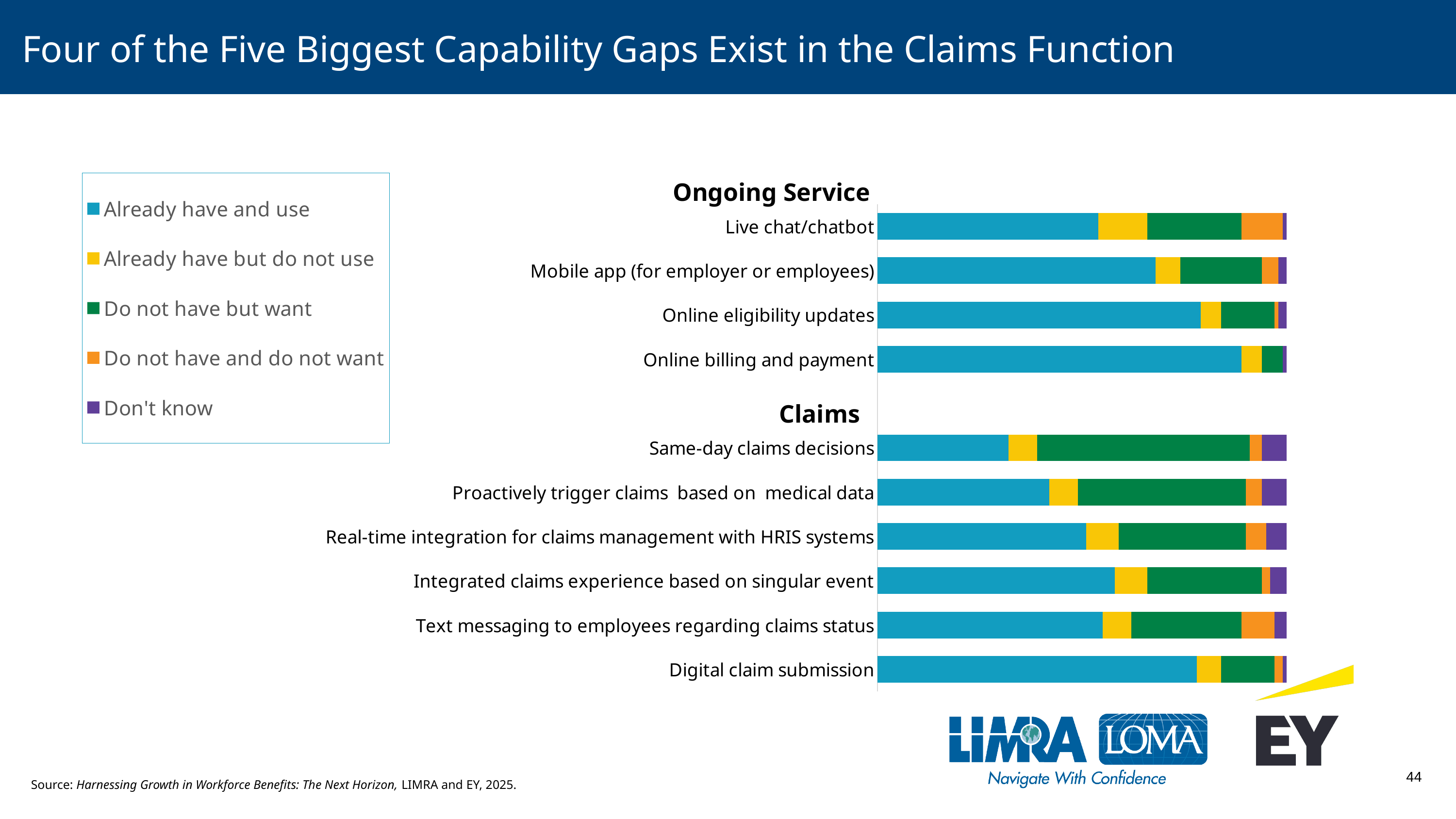
How many series does the legend list? 5 Is the 'Already have and use' segment larger for Live chat/chatbot or for Online eligibility updates? Online eligibility updates Which category has the largest 'Already have and use' segment? Online billing and payment Is the 'Do not have but want' segment larger for Same-day claims decisions or for Online billing and payment? Same-day claims decisions Which category has the largest 'Do not have but want' segment? Same-day claims decisions How many categories are listed under the Ongoing Service group? 4 Which colour represents 'Don't know' in the legend? Purple Which category has the smallest 'Already have and use' segment? Same-day claims decisions How many categories are listed under the Claims group? 6 How many capability categories are plotted in the chart in total? 10 What kind of chart is shown on the slide? Stacked bar chart What are the two group headings shown in the chart? Ongoing Service and Claims